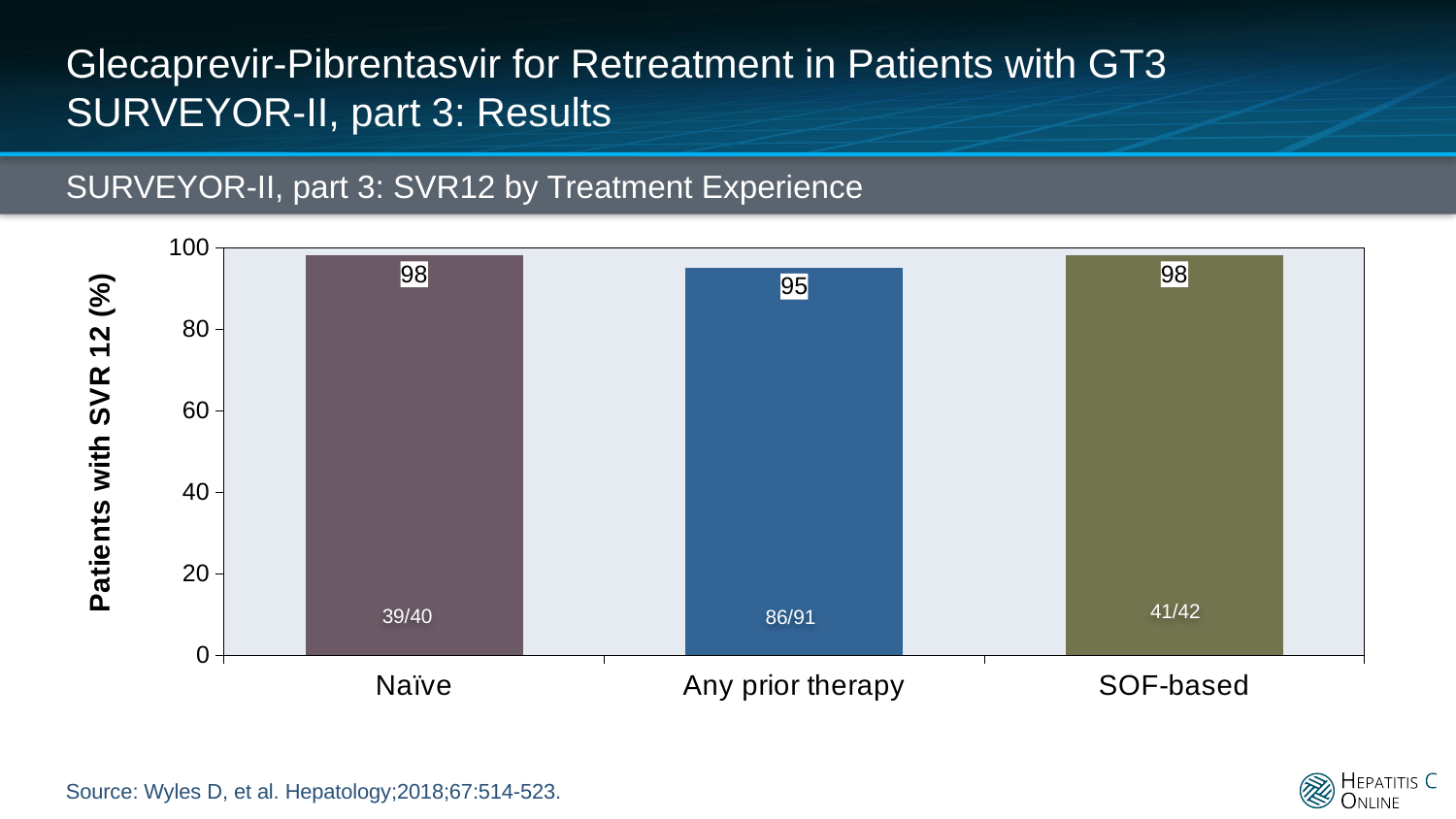
What is the title of the chart? SURVEYOR-II, part 3: SVR12 by Treatment Experience What type of chart is shown on the slide? Bar chart Which group has the lowest SVR12 rate? Any prior therapy What fraction of patients is shown inside the Any prior therapy bar? 86/91 What is the SVR12 rate for the SOF-based group? 98 What is the SVR12 rate for the Naïve group? 98 What fraction of patients is shown inside the SOF-based bar? 41/42 How many treatment experience groups are shown in the chart? 3 What is the label of the y-axis? Patients with SVR 12 (%) What is the difference in SVR12 rate between the Naïve group and the Any prior therapy group? 3 Which has a higher SVR12 rate, Naïve or Any prior therapy? Naïve What is the SVR12 rate for the Any prior therapy group? 95